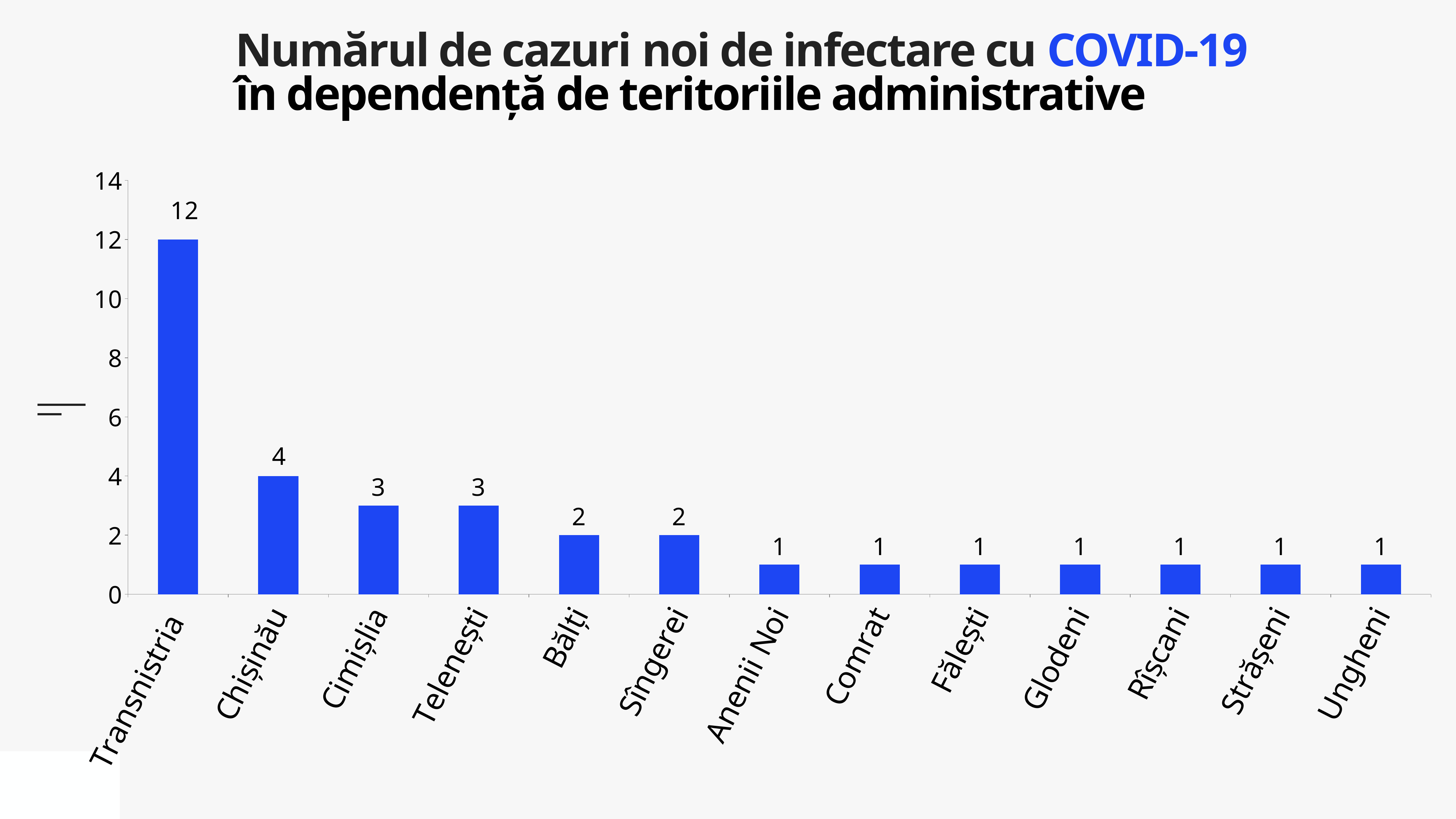
What is the difference between the values for Transnistria and Chișinău? 8 Which category has the highest value? Transnistria Which is larger, the value for Telenești or the value for Comrat? Telenești What is the value for Bălți? 2 What is the value for Transnistria? 12 Do the values rise or fall from left to right along the x axis? fall What is the value for Chișinău? 4 How many categories are shown on the x axis? 13 Is the value for Transnistria greater or less than 10? greater What is the value for Ungheni? 1 What is the difference between the values for Cimișlia and Sîngerei? 1 What kind of chart is shown on the slide? bar chart